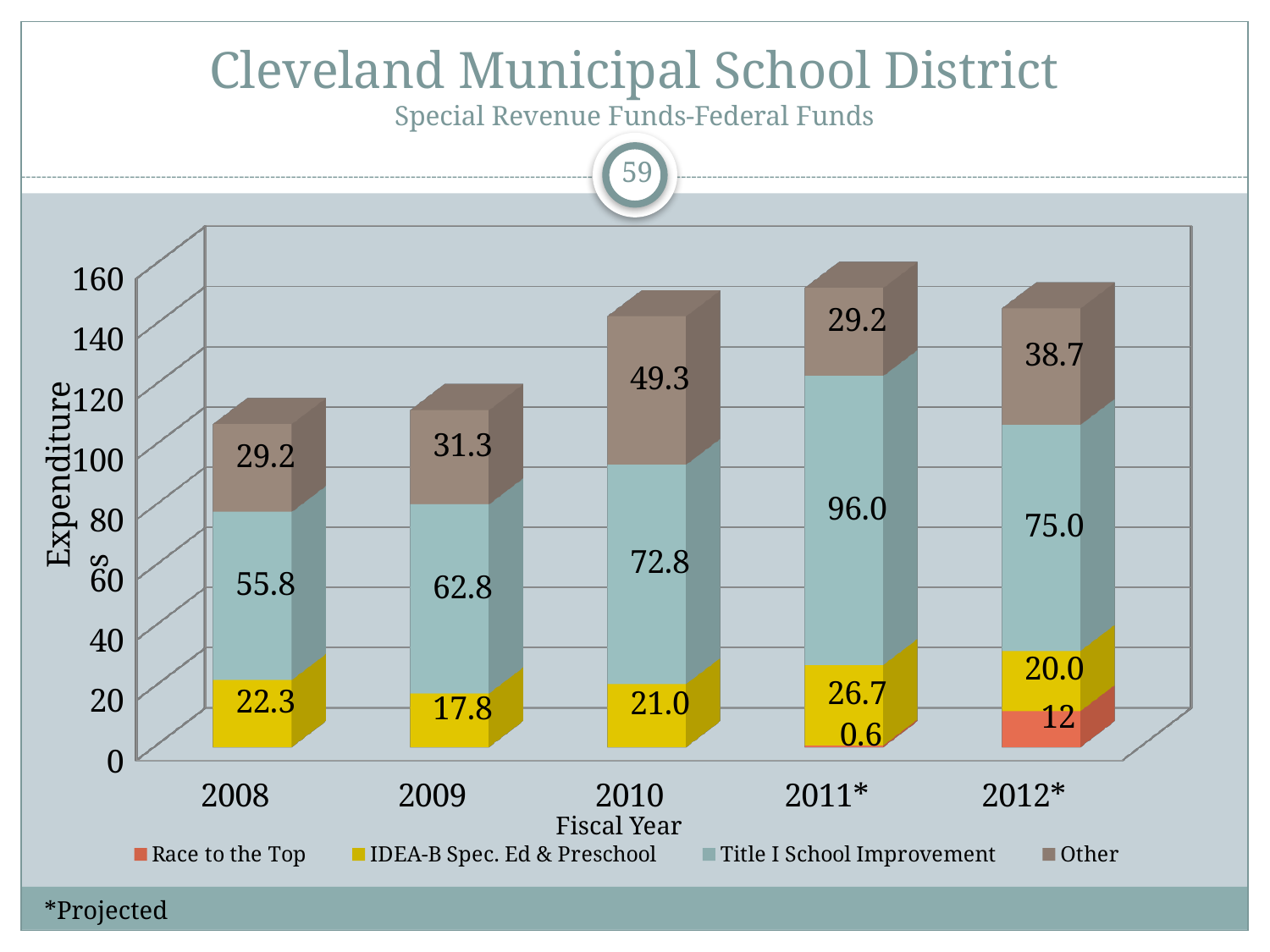
What is the total of the stacked bar for 2011*? 152.5 What is the value for Other in 2010? 49.3 What is the value for Race to the Top in 2012*? 12 How many fiscal years are shown on the x axis? 5 In which fiscal year is the IDEA-B Spec. Ed & Preschool value lowest? 2009 What is the difference between the Other value in 2012* and the Other value in 2011*? 9.5 What kind of chart is shown on the slide? Stacked bar chart Which is larger: Title I School Improvement in 2010 or in 2012*? 2012* What is the value for Title I School Improvement in 2011*? 96.0 In which fiscal year is the Title I School Improvement value highest? 2011* Is the total of the 2008 bar greater or less than 100? greater How many series does the legend list? 4